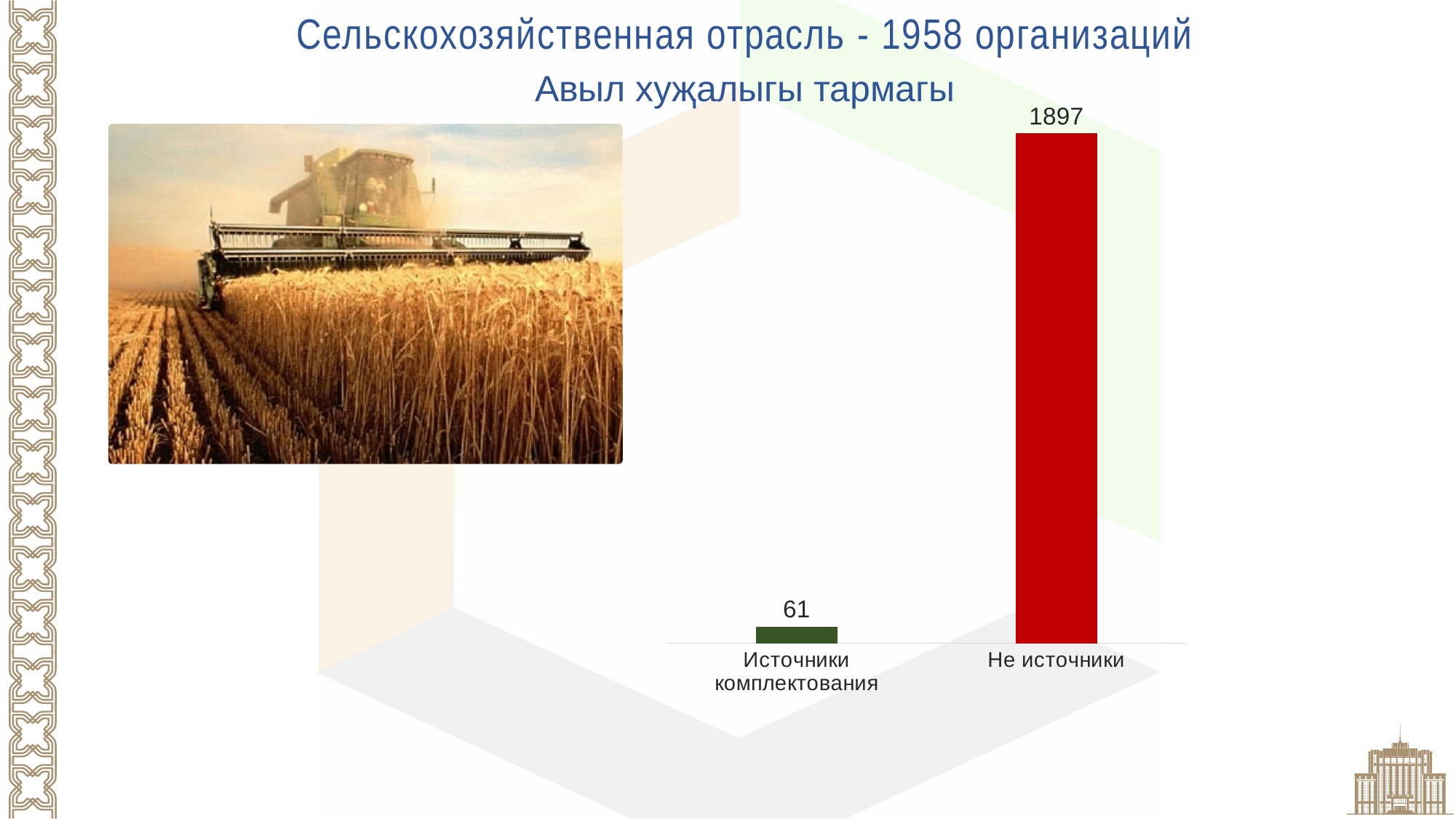
Which category has the lowest value? Источники комплектования What is the total of the two values shown in the chart? 1958 What is the difference between the values for Не источники and Источники комплектования? 1836 What colour is the bar for Не источники? Red Which category has the highest value? Не источники What kind of chart is shown on the slide? Bar chart Which is larger, the value for Источники комплектования or the value for Не источники? Не источники How many categories are shown in the chart? 2 What colour is the bar for Источники комплектования? Green What is the value for Не источники? 1897 What is the value for Источники комплектования? 61